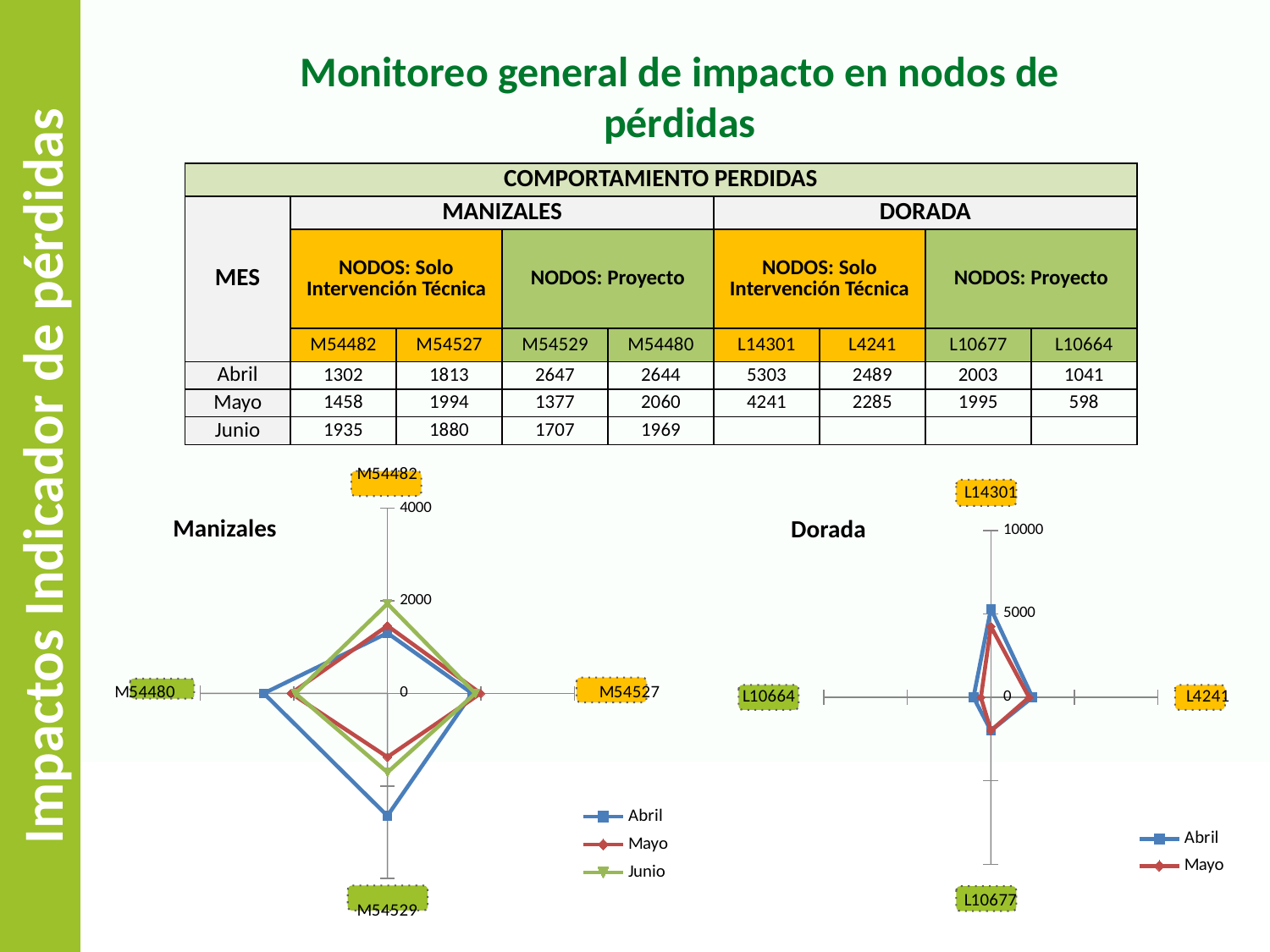
How many series does the legend of the Dorada chart list? 2 On the Manizales chart, is the Abril value for M54529 greater or less than 2000? greater On the Manizales chart, which is larger for node M54529: the Abril value or the Junio value? Abril On the Manizales chart, which node has the lowest Abril value? M54482 On the Dorada chart, is the Mayo value for L10664 greater or less than 5000? less How many nodes (axes) are plotted on the Dorada chart? 4 On the Dorada chart, what is the difference between the Abril and Mayo values for L14301? 1062 How many series does the legend of the Manizales chart list? 3 On the Dorada chart, which node has the highest Abril value? L14301 What is the highest axis tick value shown on the Dorada chart? 10000 On the Manizales chart, what is the Abril value for node M54529? 2647 What kind of chart is the Manizales chart? radar chart